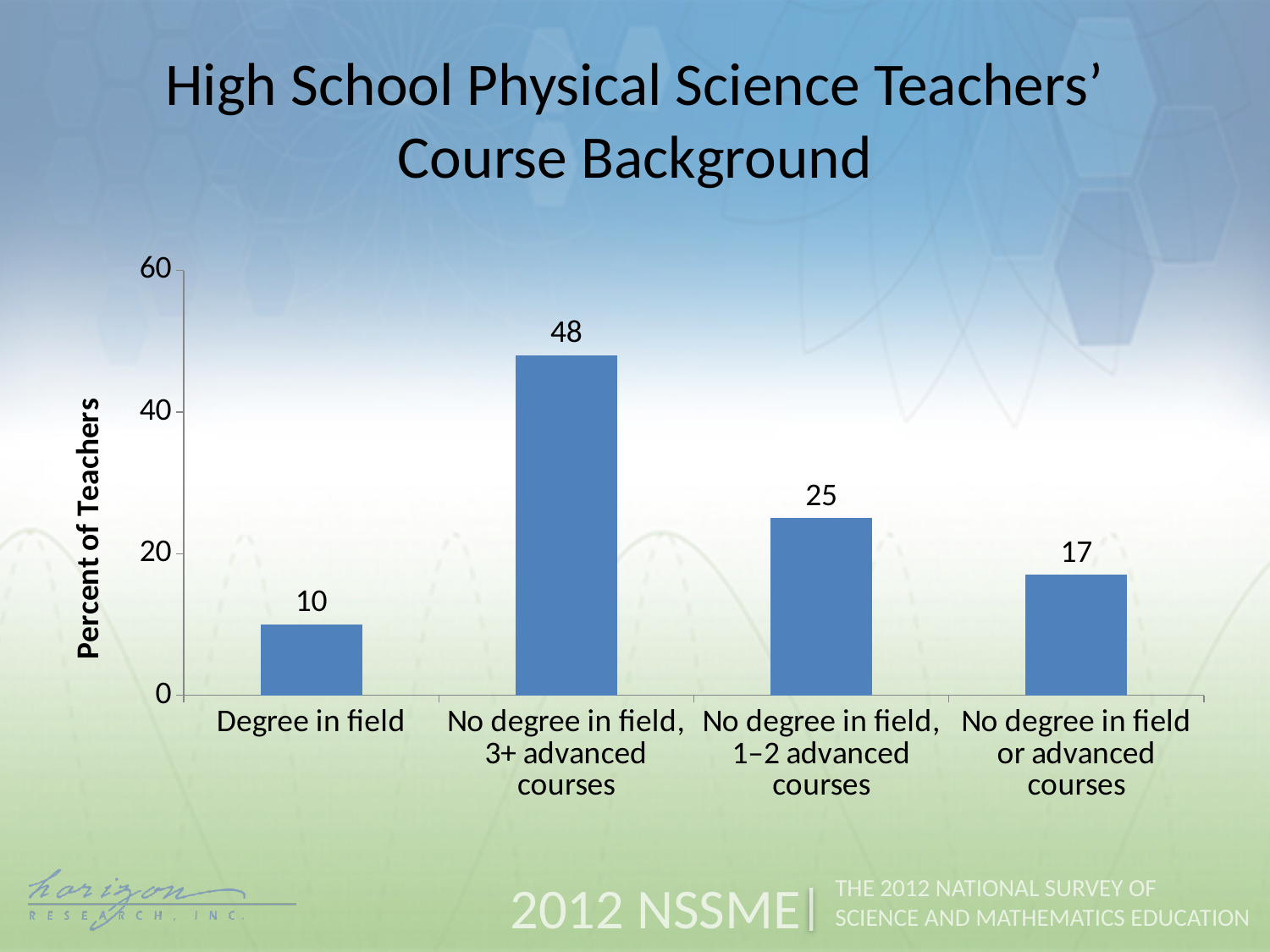
What is the label of the y axis? Percent of Teachers How many categories are shown on the x axis? 4 What is the difference between the values for 'No degree in field, 3+ advanced courses' and 'No degree in field, 1–2 advanced courses'? 23 What percent of teachers have a degree in field? 10 Which category has the highest percent of teachers? No degree in field, 3+ advanced courses What kind of chart is shown on the slide? bar chart Is the value for 'No degree in field, 3+ advanced courses' greater or less than 40? greater What is the value for 'No degree in field, 1–2 advanced courses'? 25 What is the value for 'No degree in field, 3+ advanced courses'? 48 Which is larger: the value for 'No degree in field, 1–2 advanced courses' or 'No degree in field or advanced courses'? No degree in field, 1–2 advanced courses What is the value for 'No degree in field or advanced courses'? 17 Which category has the lowest percent of teachers? Degree in field